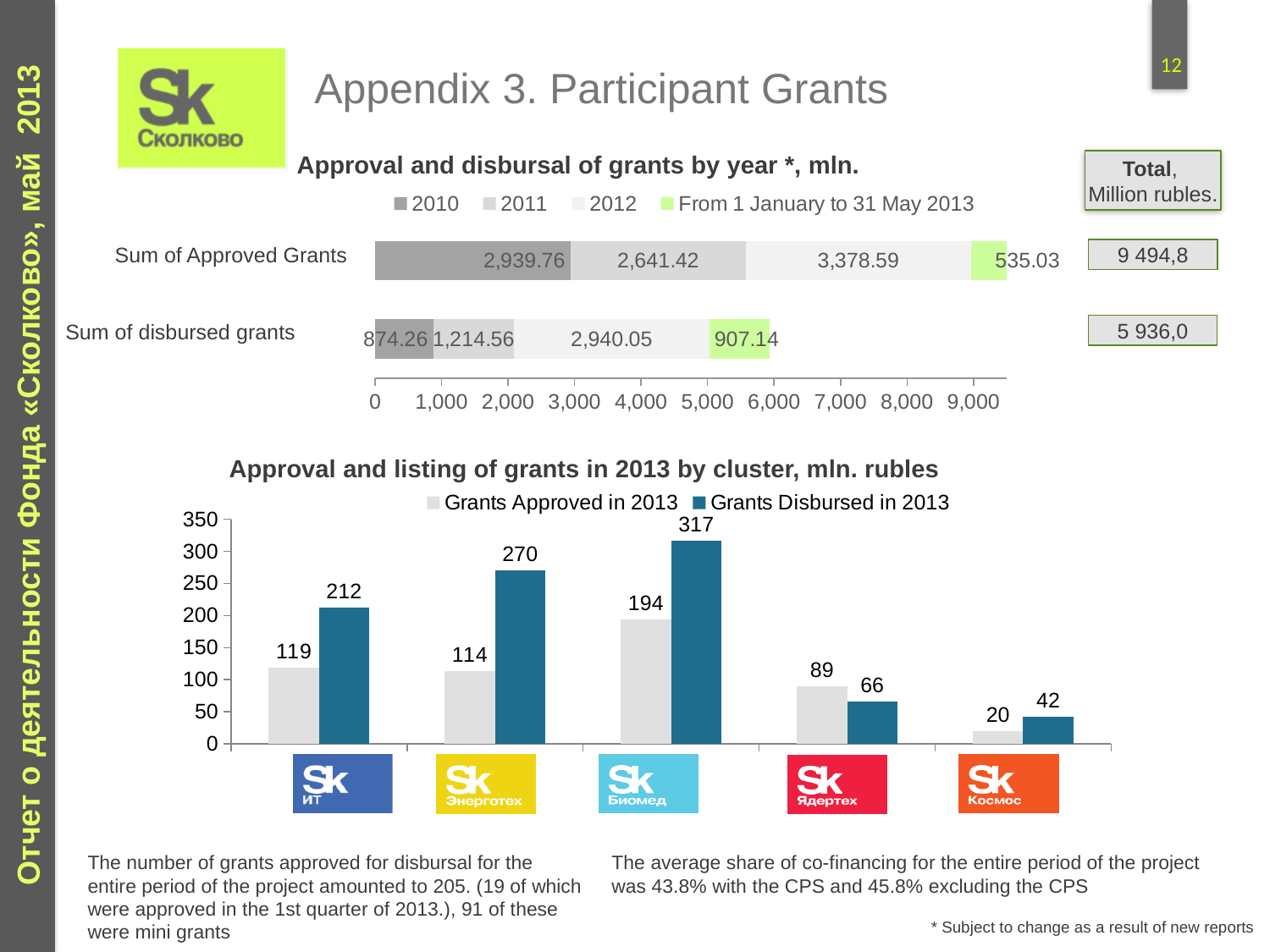
What kind of chart is the 'Approval and disbursal of grants by year' chart? Stacked bar chart In the 'Approval and listing of grants in 2013 by cluster' chart, what is the value of Grants Approved in 2013 for the ИТ cluster? 119 How many clusters are shown in the 'Approval and listing of grants in 2013 by cluster' chart? 5 In the 'Approval and disbursal of grants by year' chart, what is the 2011 value for Sum of disbursed grants? 1,214.56 In the 'Approval and disbursal of grants by year' chart, what is the 2012 value for Sum of Approved Grants? 3,378.59 In the 'Approval and listing of grants in 2013 by cluster' chart, which cluster has the lowest value of Grants Disbursed in 2013? Космос In the 'Approval and listing of grants in 2013 by cluster' chart, what is the difference between Grants Disbursed in 2013 and Grants Approved in 2013 for the Энерготех cluster? 156 In the 'Approval and listing of grants in 2013 by cluster' chart, for the Ядертех cluster, which is larger: Grants Approved in 2013 or Grants Disbursed in 2013? Grants Approved in 2013 How many series does the legend of the 'Approval and listing of grants in 2013 by cluster' chart list? 2 How many series does the legend of the 'Approval and disbursal of grants by year' chart list? 4 In the 'Approval and listing of grants in 2013 by cluster' chart, what is the value of Grants Disbursed in 2013 for the Биомед cluster? 317 In the 'Approval and listing of grants in 2013 by cluster' chart, which cluster has the highest value of Grants Approved in 2013? Биомед